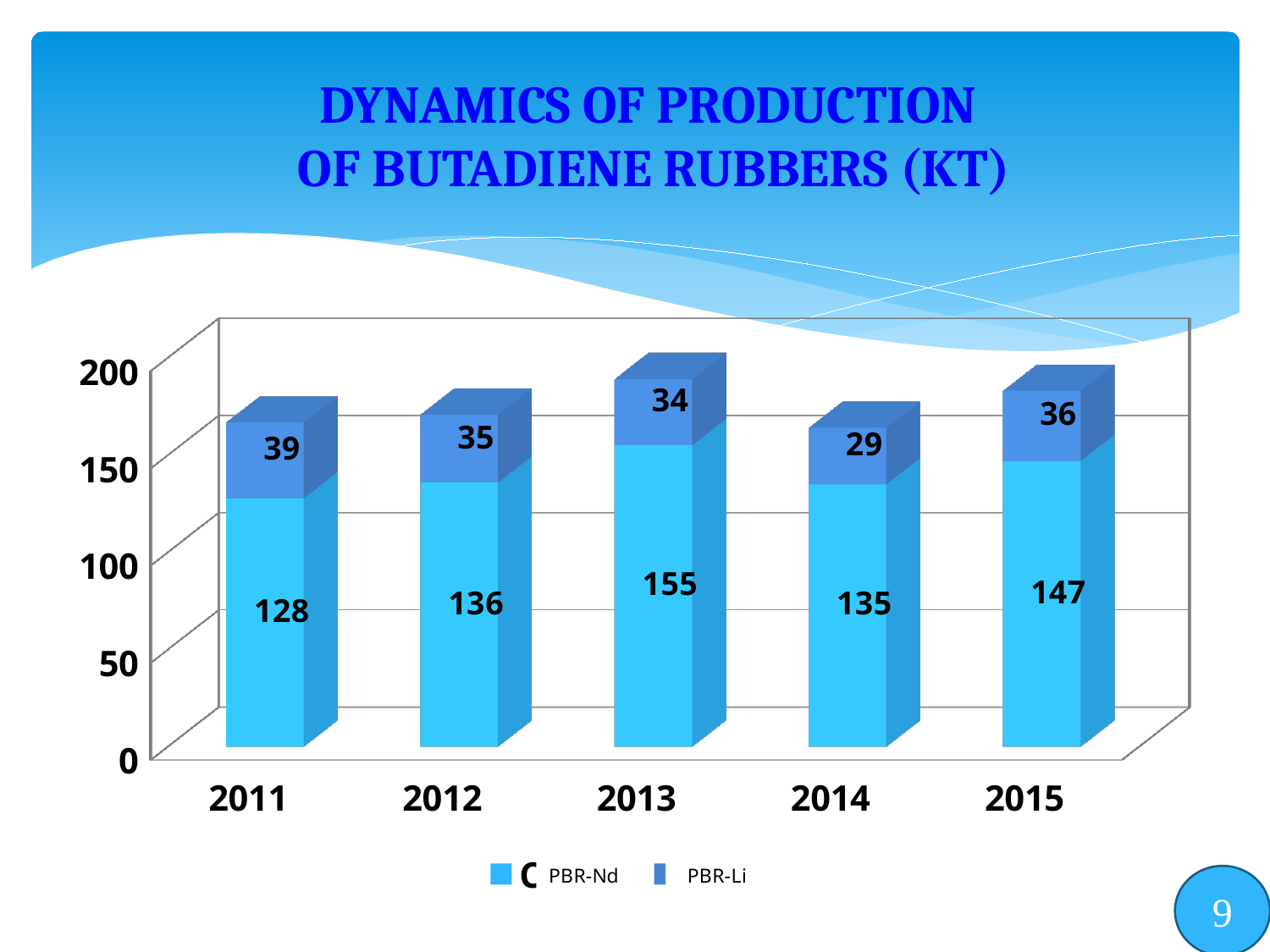
What is the PBR-Nd value for 2011? 128 How many series does the legend list? 2 What kind of chart is shown on the slide? Stacked bar chart What is the total of the stacked bar for 2013? 189 What is the PBR-Nd value for 2013? 155 Which is larger, the PBR-Li value for 2011 or for 2015? 2011 What is the PBR-Li value for 2014? 29 How many years are shown on the x axis? 5 What is the difference between the PBR-Nd values for 2015 and 2014? 12 Which year has the lowest PBR-Li value? 2014 What is the total of the stacked bar for 2011? 167 Which year has the highest PBR-Nd value? 2013